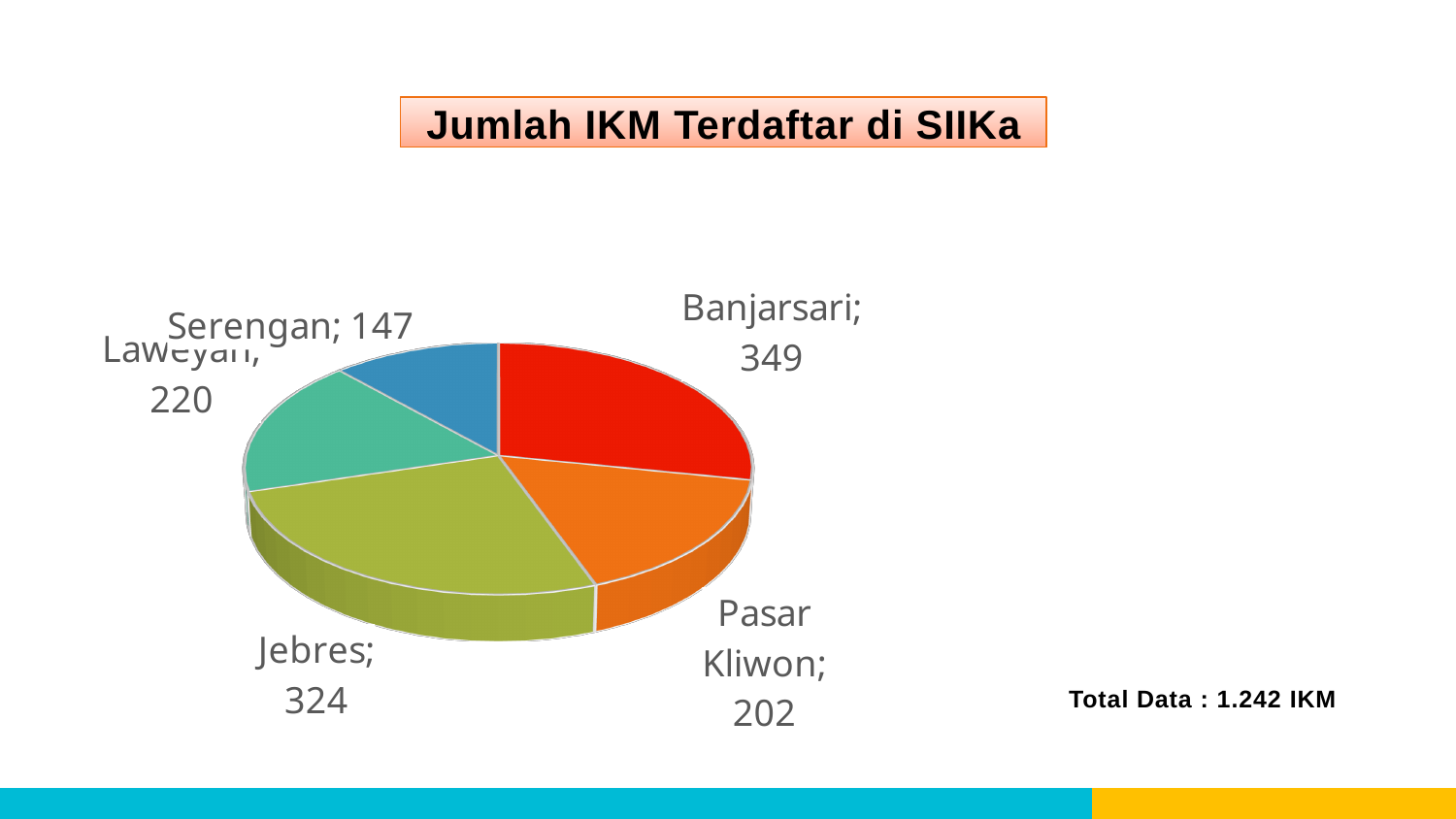
What is the value for Laweyan? 220 Which is larger, the value for Laweyan or the value for Pasar Kliwon? Laweyan What is the value for Pasar Kliwon? 202 What is the title of the chart? Jumlah IKM Terdaftar di SIIKa What is the value for Serengan? 147 What is the value for Banjarsari? 349 Which category has the highest value? Banjarsari What is the total of all the slices in the pie chart? 1.242 What kind of chart is shown on the slide? Pie chart Which category has the lowest value? Serengan What is the difference between the values for Banjarsari and Jebres? 25 How many categories are shown in the pie chart? 5